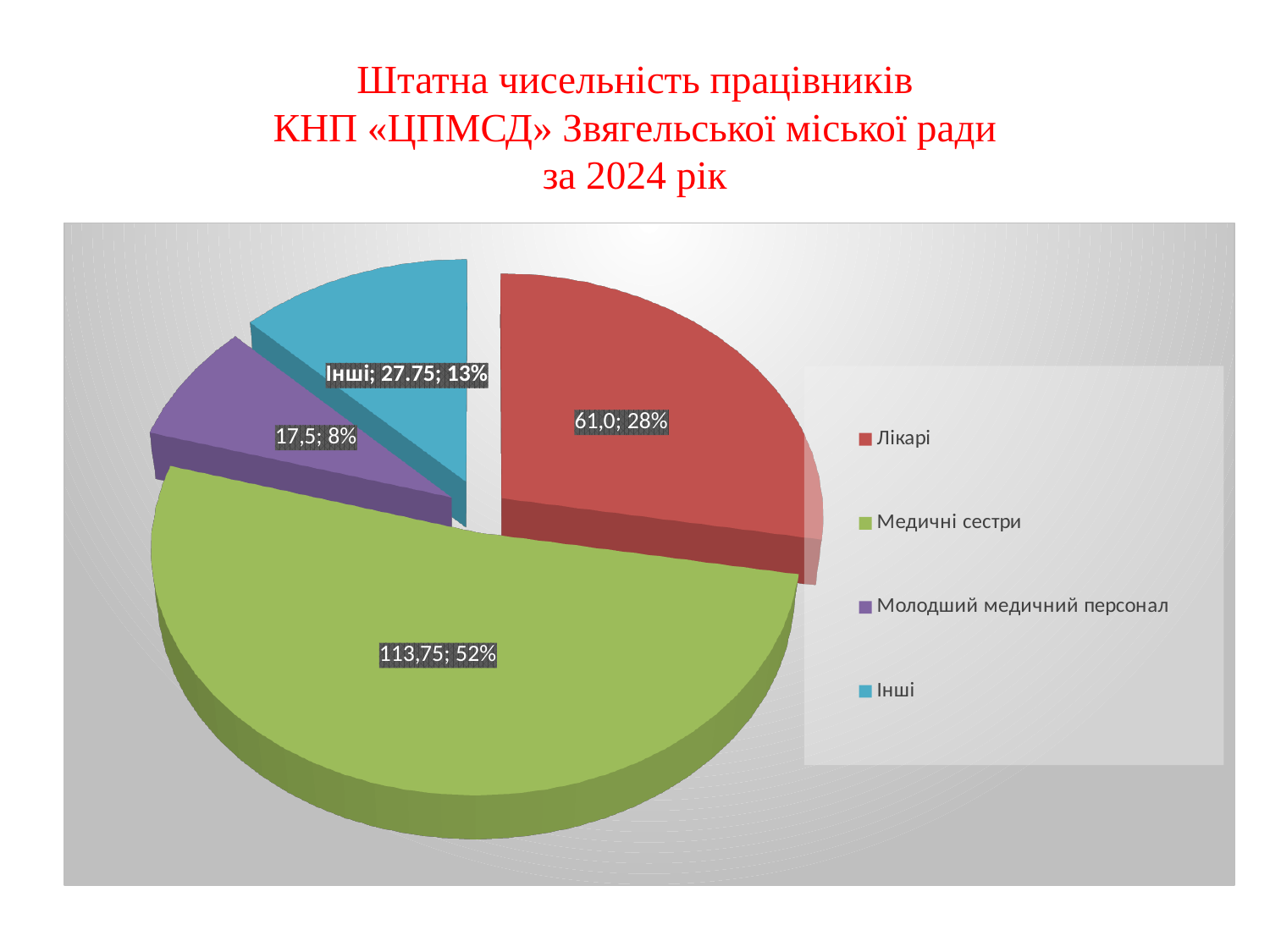
What is the value shown for Медичні сестри? 113,75 How many categories does the legend list? 4 What is the value shown for Молодший медичний персонал? 17,5 What share of the pie does Молодший медичний персонал represent? 8% What share of the pie does Медичні сестри represent? 52% What is the value shown for Інші? 27.75 What is the value shown for Лікарі? 61,0 Which category has the smallest slice? Молодший медичний персонал What type of chart is shown on the slide? pie chart What share of the pie does Лікарі represent? 28% Which category has the largest slice? Медичні сестри Which is larger, the value for Лікарі or the value for Інші? Лікарі